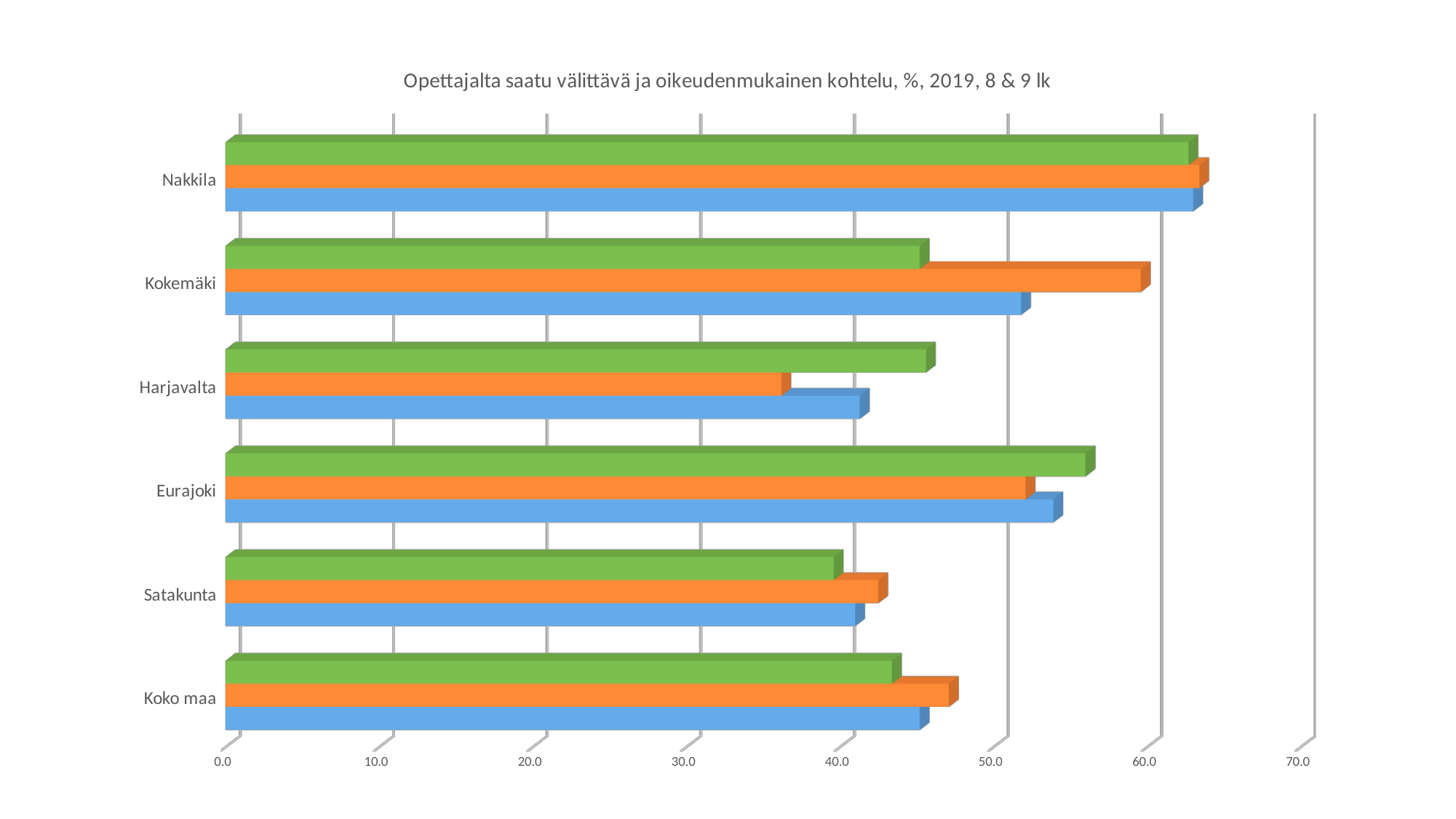
What kind of chart is shown on the slide? bar chart Is the orange bar for Kokemäki greater or less than 50.0? greater What is the title of the chart? Opettajalta saatu välittävä ja oikeudenmukainen kohtelu, %, 2019, 8 & 9 lk Which has the longer blue bar, Eurajoki or Satakunta? Eurajoki Which category has the longest green bar? Nakkila Which category has the shortest orange bar? Harjavalta Is the orange bar for Harjavalta greater or less than 40.0? less Is the blue bar for Koko maa greater or less than 40.0? greater Which has the longer orange bar, Kokemäki or Harjavalta? Kokemäki How many categories are shown on the vertical axis of the chart? 6